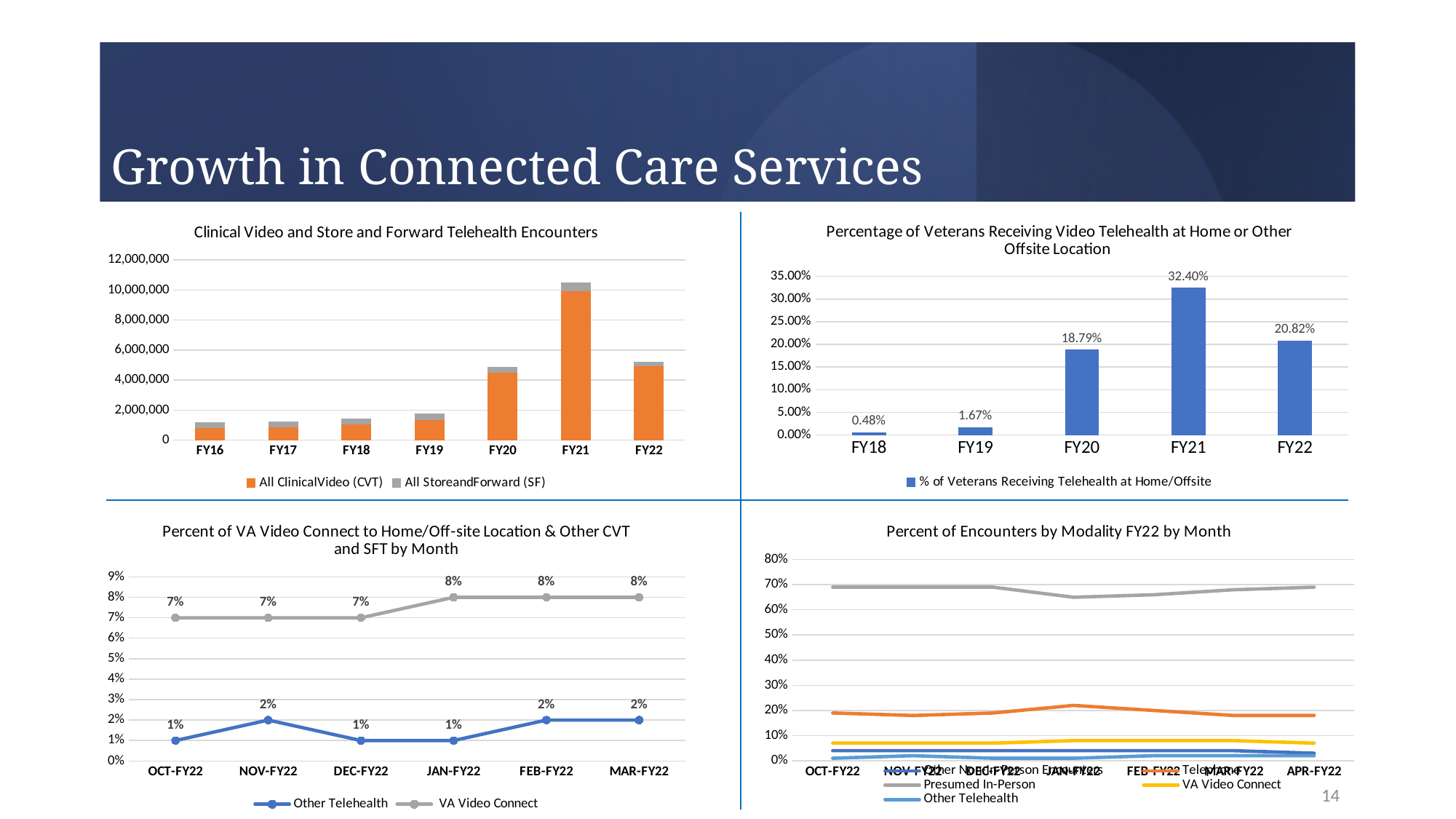
In the 'Percent of VA Video Connect to Home/Off-site Location & Other CVT and SFT by Month' chart, what is the Other Telehealth value for NOV-FY22? 2% In the 'Percentage of Veterans Receiving Video Telehealth at Home or Other Offsite Location' chart, what is the value for FY21? 32.40% In the 'Percent of VA Video Connect to Home/Off-site Location & Other CVT and SFT by Month' chart, which series is higher in MAR-FY22, Other Telehealth or VA Video Connect? VA Video Connect In the 'Clinical Video and Store and Forward Telehealth Encounters' chart, is the total for FY21 greater or less than 10,000,000? greater In the 'Percent of Encounters by Modality FY22 by Month' chart, is the Presumed In-Person value for OCT-FY22 greater or less than 60%? greater What type of chart is 'Clinical Video and Store and Forward Telehealth Encounters'? Stacked bar chart In the 'Percentage of Veterans Receiving Video Telehealth at Home or Other Offsite Location' chart, what is the difference between the FY21 and FY22 values? 11.58% In the 'Clinical Video and Store and Forward Telehealth Encounters' chart, how many series does the legend list? 2 In the 'Percentage of Veterans Receiving Video Telehealth at Home or Other Offsite Location' chart, how many fiscal years are shown? 5 In the 'Percent of VA Video Connect to Home/Off-site Location & Other CVT and SFT by Month' chart, what is the VA Video Connect value for JAN-FY22? 8% In the 'Percentage of Veterans Receiving Video Telehealth at Home or Other Offsite Location' chart, which fiscal year has the lowest value? FY18 In the 'Clinical Video and Store and Forward Telehealth Encounters' chart, which fiscal year has the tallest stacked bar? FY21